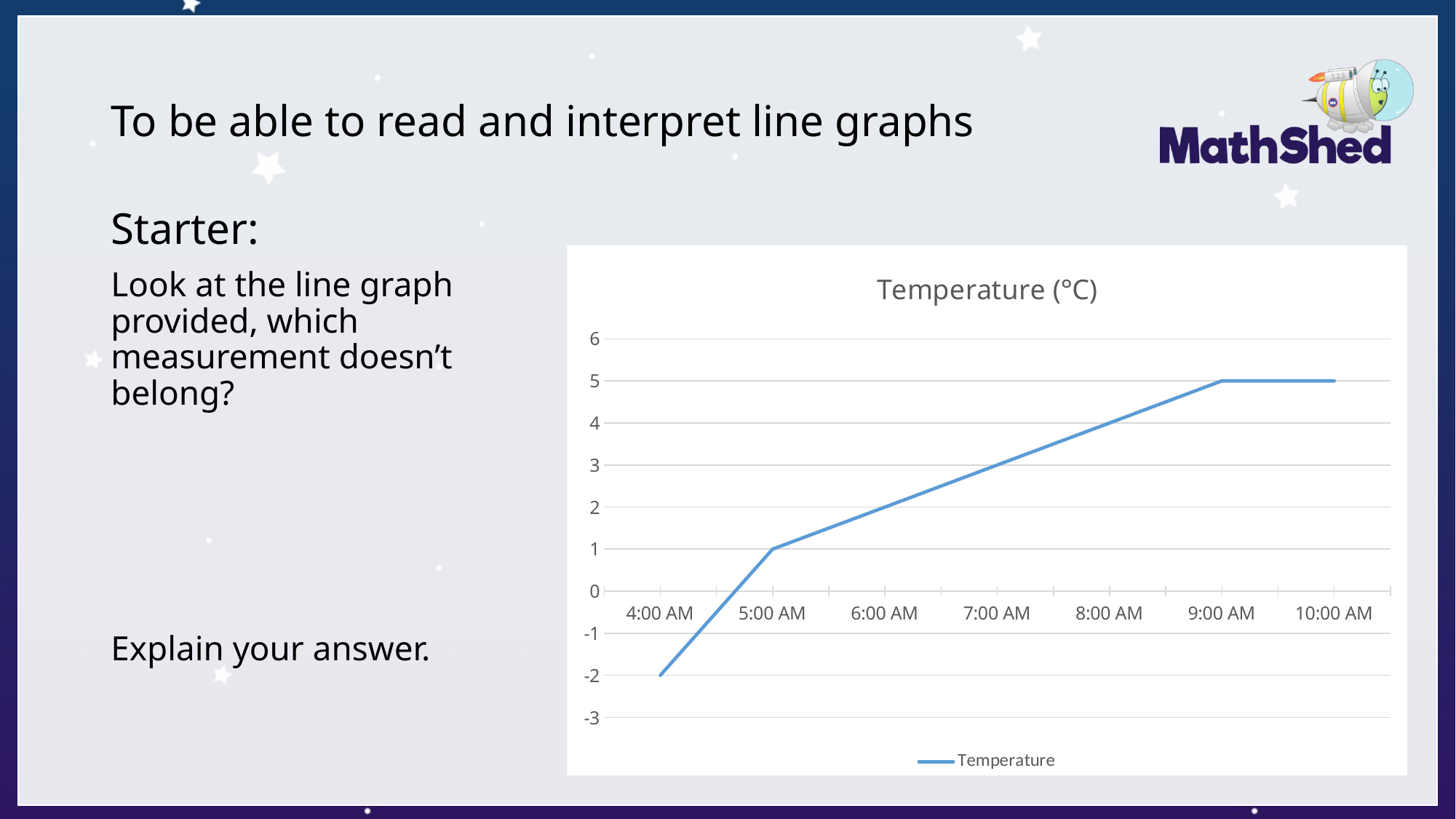
What is the difference between the temperature at 5:00 AM and at 4:00 AM? 3 What is the temperature at 5:00 AM? 1 Does the temperature rise or fall from 4:00 AM to 9:00 AM? rise What is the temperature at 4:00 AM? -2 What is the temperature at 10:00 AM? 5 How many time points are plotted along the x axis? 7 Is the temperature at 7:00 AM greater or less than 0? greater At which time is the temperature lowest? 4:00 AM What kind of chart is shown on the slide? line chart How many series does the legend list? 1 What is the title of the chart? Temperature (°C) What is the temperature at 9:00 AM? 5